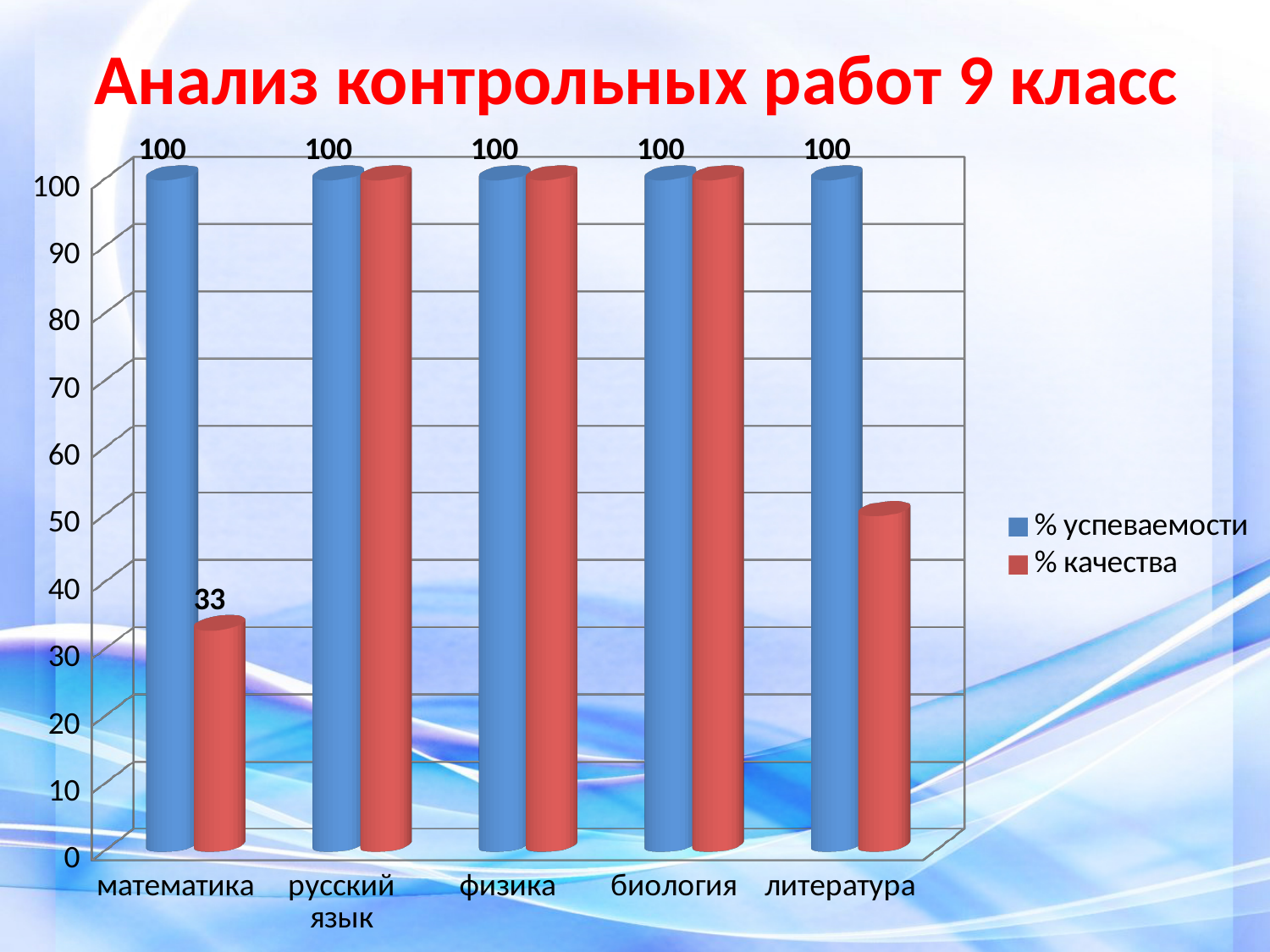
Is the value of % качества for литература greater or less than 70? less What is the value of % качества for математика? 33 For математика, which is larger: % успеваемости or % качества? % успеваемости What is the title of the slide? Анализ контрольных работ 9 класс Is the value of % качества for литература greater or less than 40? greater What is the value of % успеваемости for математика? 100 What is the difference between % успеваемости and % качества for математика? 67 What is the value of % успеваемости for литература? 100 What kind of chart is shown on the slide? bar chart How many categories are shown on the x axis? 5 Which category has the lowest % качества? математика How many series does the legend list? 2